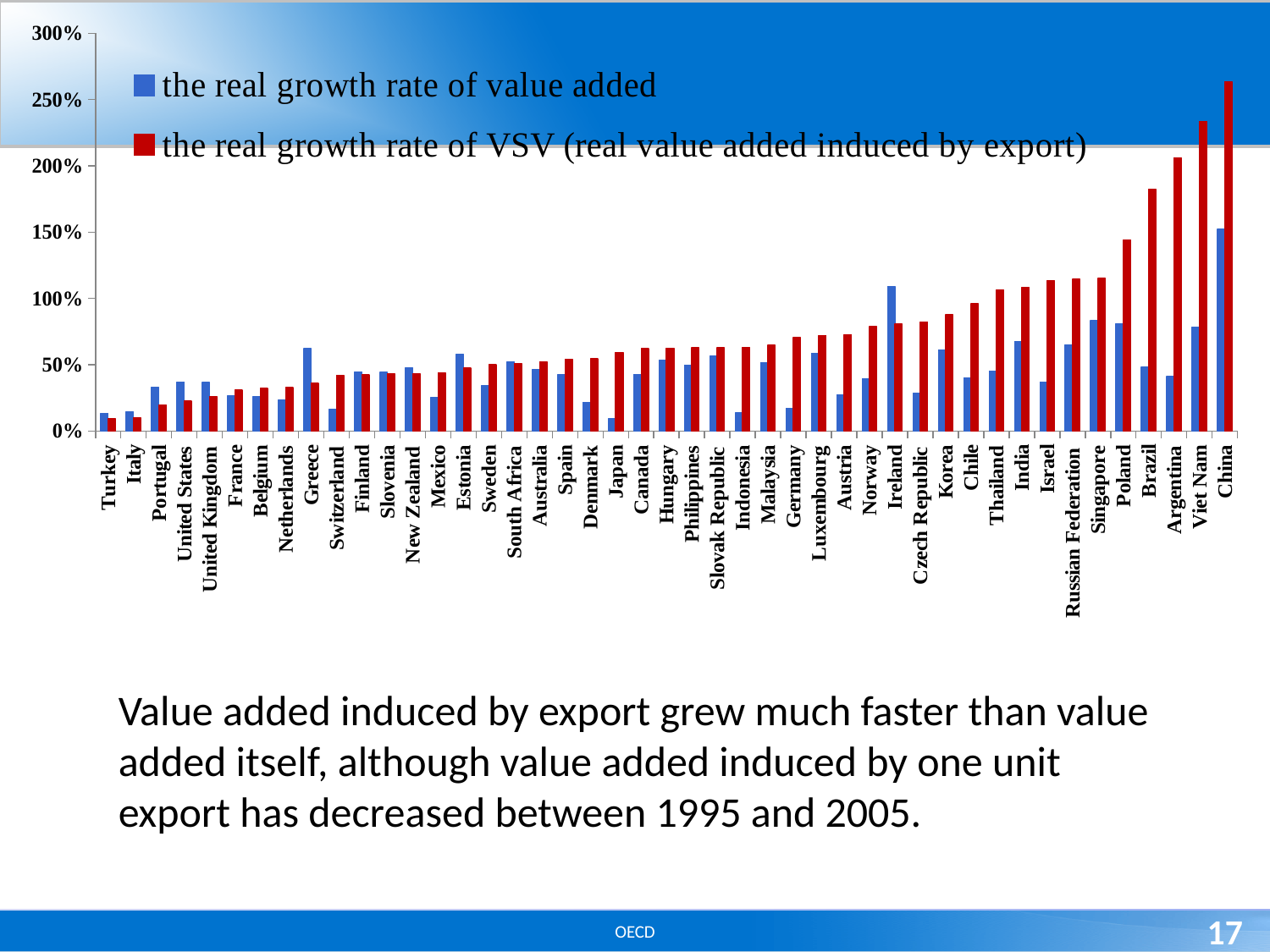
How many countries are shown on the x axis? 45 Which country has the highest real growth rate of VSV (red bar)? China What colour are the bars for the real growth rate of VSV? red Do the real growth rates of VSV (red bars) generally rise or fall from left to right along the x axis? rise How many series does the legend list? 2 Is the real growth rate of value added for Ireland greater or less than 100%? greater Which country has the highest real growth rate of value added (blue bar)? China Is the real growth rate of VSV for China greater or less than 250%? greater What kind of chart is shown on the slide? bar chart Is the real growth rate of VSV for Turkey greater or less than 50%? less For Ireland, which is larger: the real growth rate of value added or the real growth rate of VSV? the real growth rate of value added